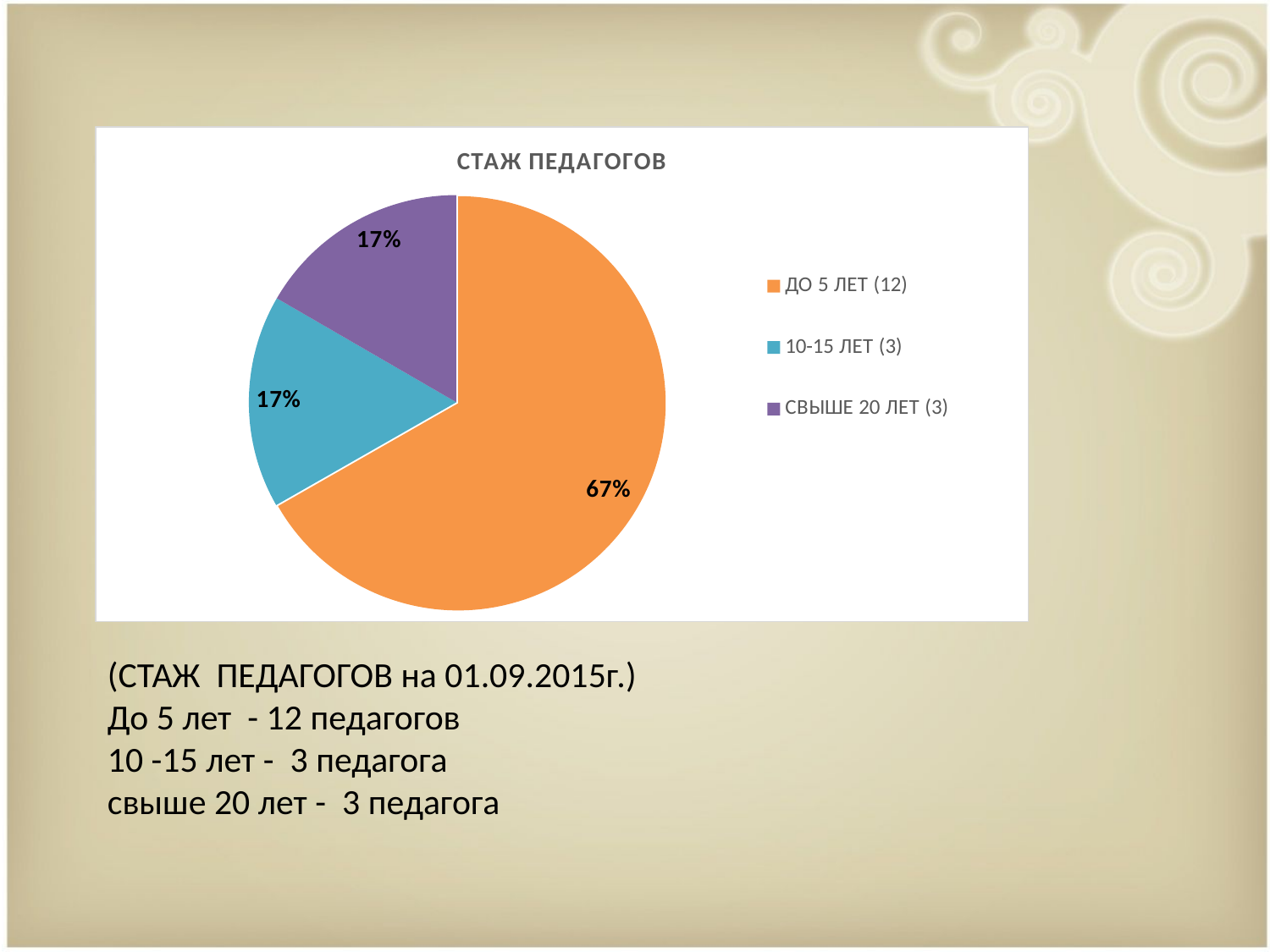
Is the share of the ДО 5 ЛЕТ (12) slice greater or less than 50%? greater Which is larger, the ДО 5 ЛЕТ (12) slice or the СВЫШЕ 20 ЛЕТ (3) slice? ДО 5 ЛЕТ (12) What is the title of the chart? СТАЖ ПЕДАГОГОВ What share of the pie does the СВЫШЕ 20 ЛЕТ (3) slice represent? 17% What kind of chart is shown on the slide? pie chart How many entries does the legend list? 3 Which category has the largest slice of the pie? ДО 5 ЛЕТ (12) How many slices does the pie chart have? 3 What share of the pie does the ДО 5 ЛЕТ (12) slice represent? 67% What colour is the ДО 5 ЛЕТ (12) slice? orange What is the difference in percentage points between the ДО 5 ЛЕТ (12) slice and the 10-15 ЛЕТ (3) slice? 50% What share of the pie does the 10-15 ЛЕТ (3) slice represent? 17%